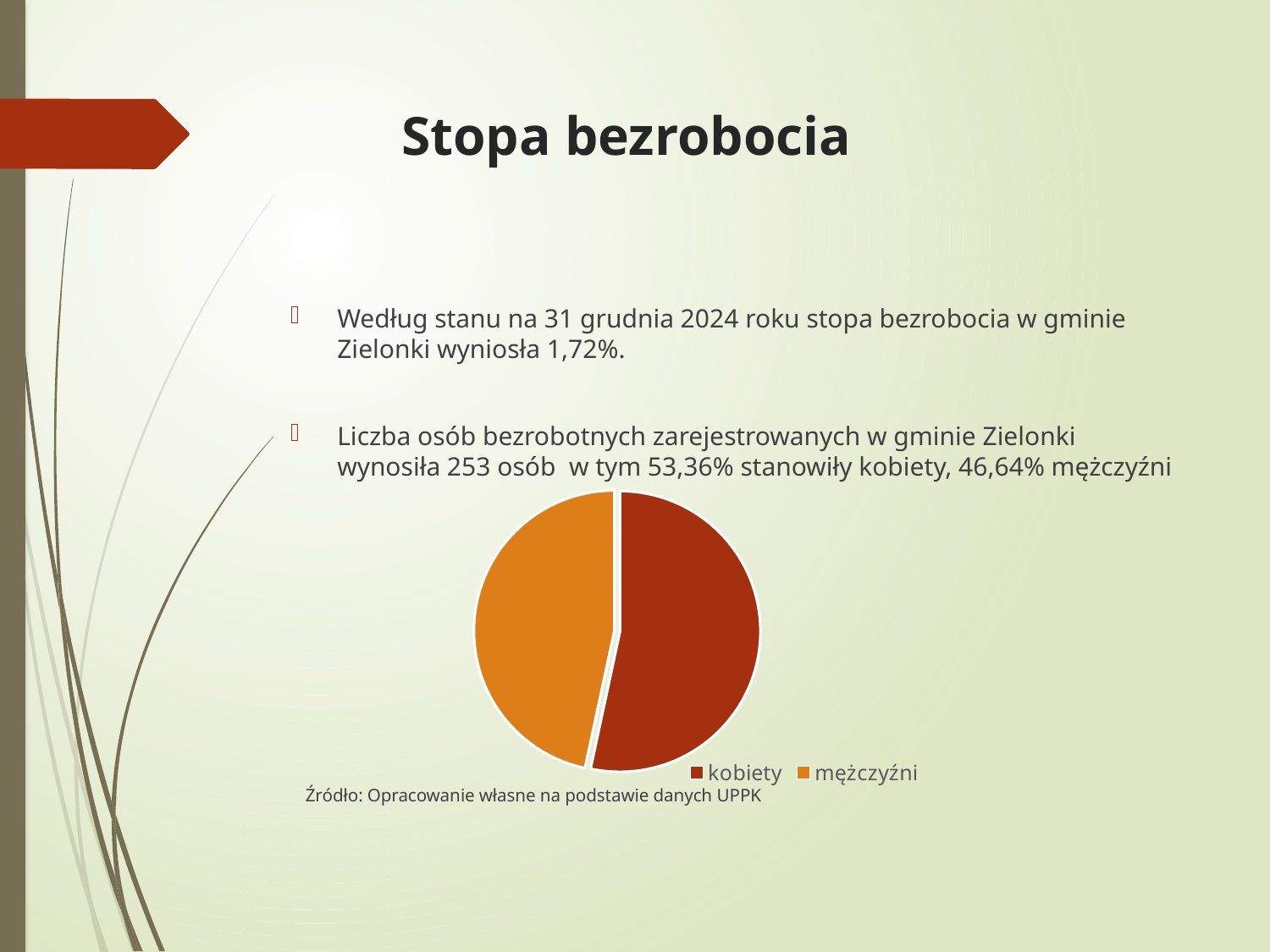
Which slice of the pie chart is the smallest? mężczyźni Is the share for kobiety greater or less than 50%? greater Which slice of the pie chart is the largest? kobiety What kind of chart is shown on the slide? pie chart How many slices does the pie chart have? 2 What are the two legend entries of the pie chart? kobiety, mężczyźni What share of the pie does the mężczyźni slice represent? 46,64% By how many percentage points does the kobiety share exceed the mężczyźni share? 6,72 Which is larger in the pie chart, the slice for kobiety or the slice for mężczyźni? kobiety What share of the pie does the kobiety slice represent? 53,36% What colour is the kobiety slice in the pie chart? dark red How many entries does the legend of the pie chart list? 2